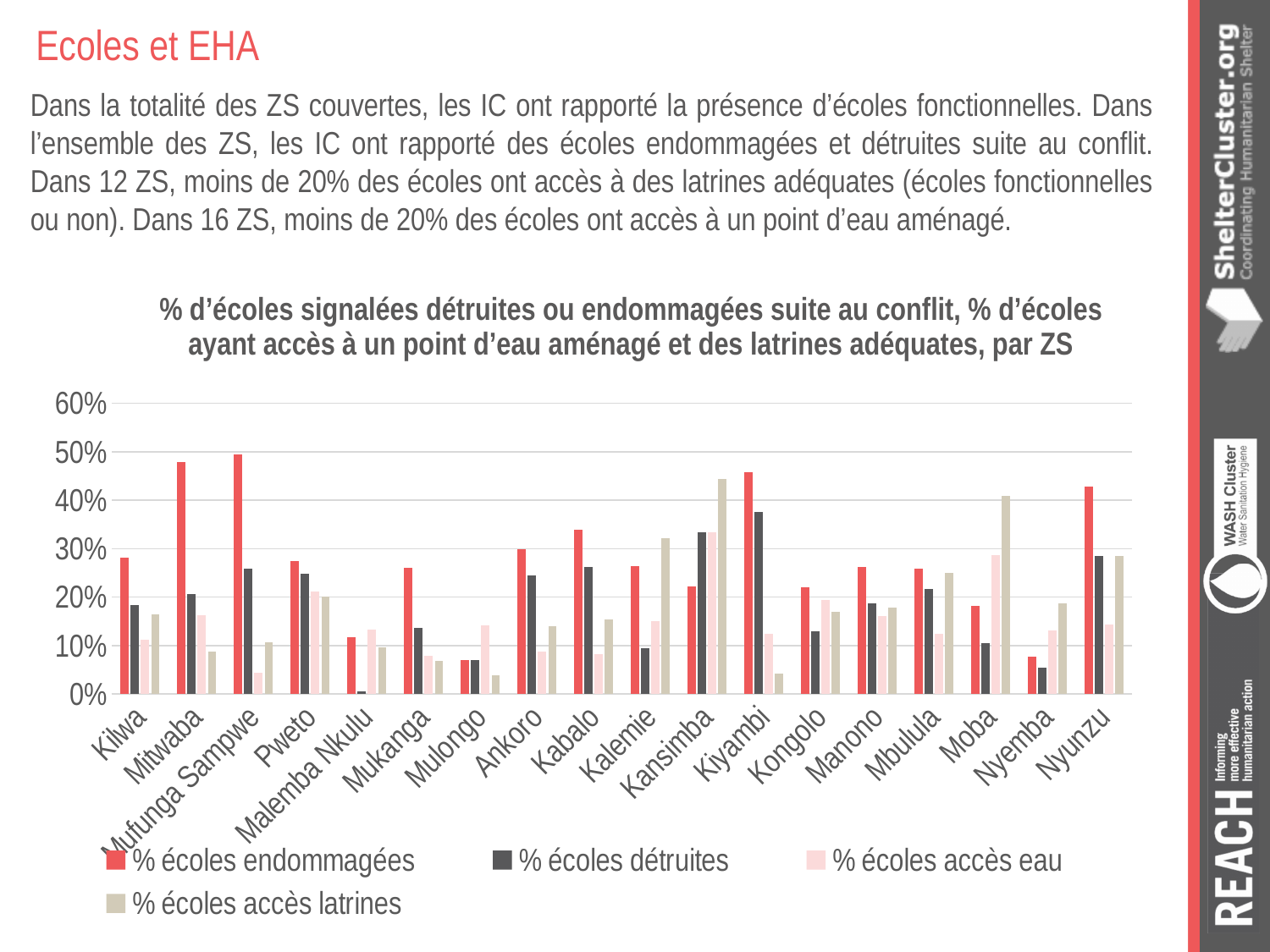
How many ZS (categories) are shown on the x axis? 18 Is the value for % écoles endommagées in Kilwa greater or less than 20%? greater How many series does the legend list? 4 Which is larger: % écoles endommagées in Kiyambi or % écoles endommagées in Kongolo? Kiyambi Which ZS has the highest value for % écoles accès eau? Kansimba Is the value for % écoles endommagées in Mitwaba greater or less than 50%? less Which ZS has the lowest value for % écoles détruites? Malemba Nkulu Is the value for % écoles accès latrines in Kansimba greater or less than 40%? greater What kind of chart is shown on the slide? bar chart Which legend entry is shown in red? % écoles endommagées Which ZS has the highest value for % écoles détruites? Kiyambi